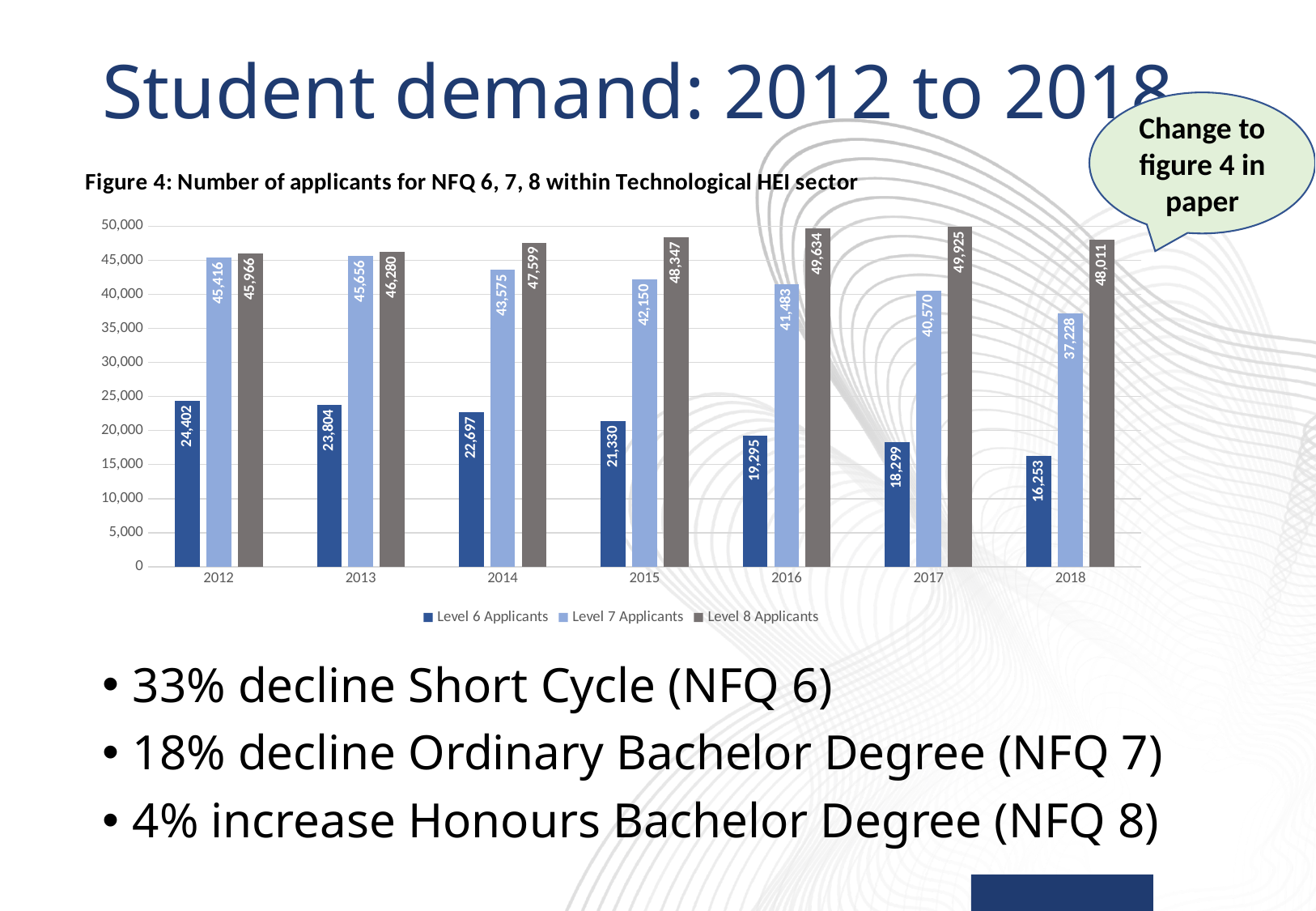
In which year were Level 6 Applicants lowest? 2018 What is the difference between Level 8 Applicants and Level 6 Applicants in 2018? 31,758 What is the number of Level 8 Applicants in 2016? 49,634 In which year were Level 8 Applicants highest? 2017 What is the number of Level 7 Applicants in 2018? 37,228 How many years are shown on the x axis of the chart? 7 What kind of chart is shown on the slide? Bar chart Do Level 6 Applicants rise or fall from 2012 to 2018? Fall What is the number of Level 6 Applicants in 2012? 24,402 In 2015, which series had more applicants: Level 7 Applicants or Level 8 Applicants? Level 8 Applicants By how much did Level 7 Applicants fall from 2012 to 2018? 8,188 How many series does the legend list? 3